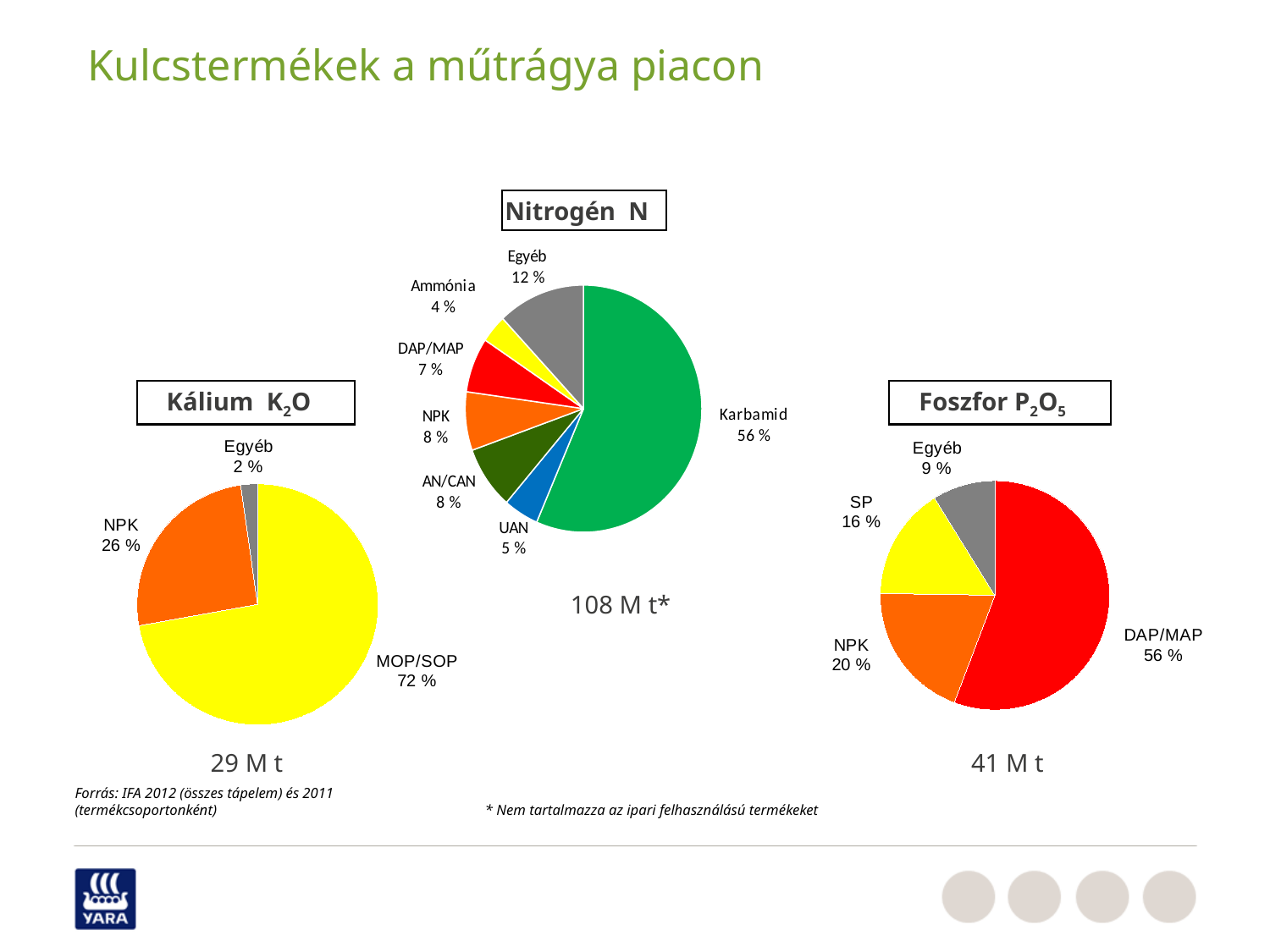
In the Nitrogén N pie chart, how many slices are there? 7 In the Kálium K2O pie chart, how many categories are shown? 3 In the Kálium K2O pie chart, which category has the largest share? MOP/SOP In the Nitrogén N pie chart, which category has the smallest share? Ammónia In the Foszfor P2O5 pie chart, what is the difference between the DAP/MAP share and the NPK share? 36 % In the Nitrogén N pie chart, what share does Karbamid have? 56 % In the Foszfor P2O5 pie chart, which is larger, NPK or SP? NPK What total volume is shown below the Foszfor P2O5 pie chart? 41 M t What type of chart is used for the Kálium K2O data? Pie chart In the Foszfor P2O5 pie chart, what share does SP have? 16 % In the Nitrogén N pie chart, what is the difference between the Egyéb share and the DAP/MAP share? 5 % In the Kálium K2O pie chart, what share does MOP/SOP have? 72 %